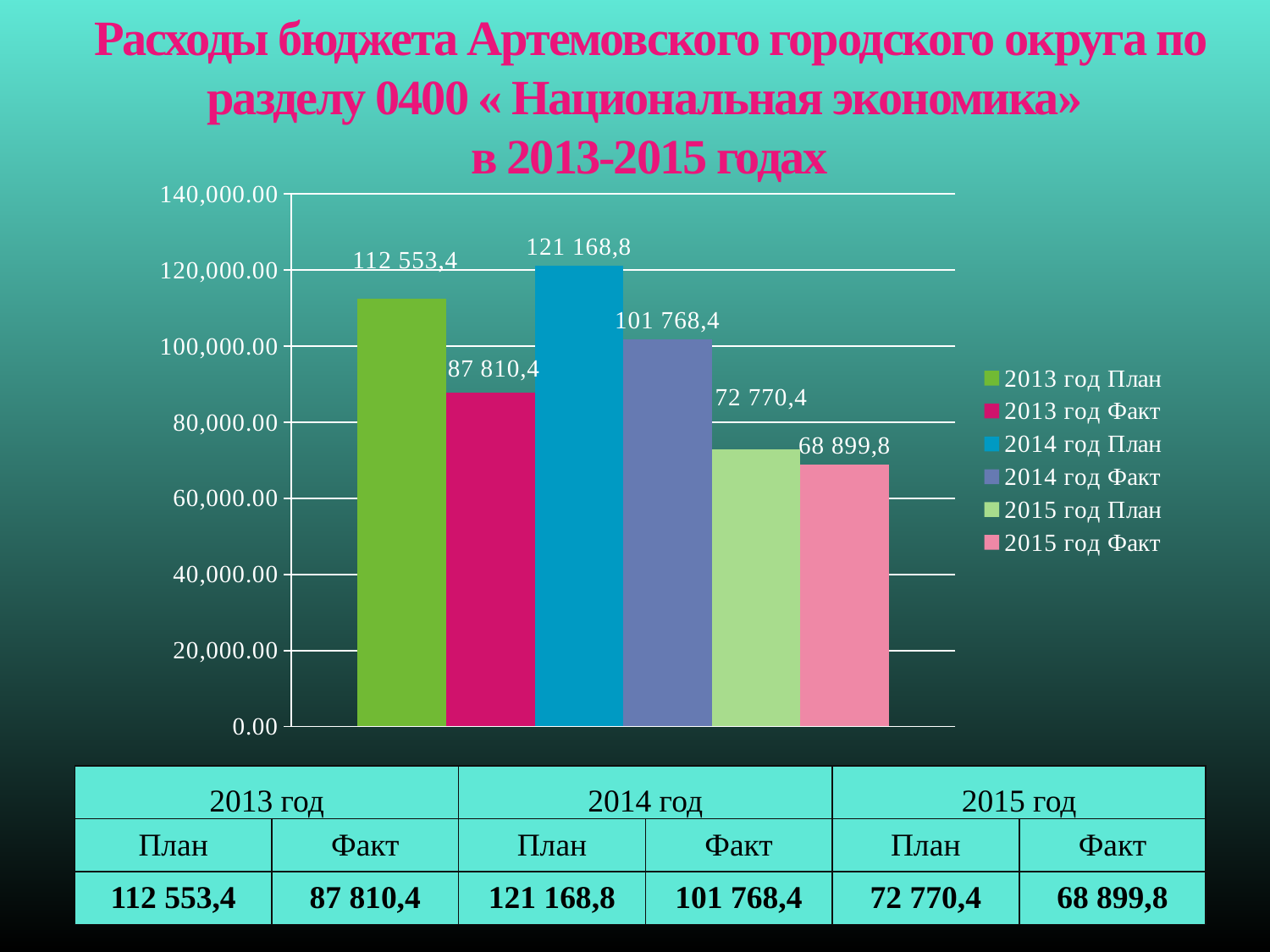
What is the difference between 2013 год План and 2013 год Факт? 24 743,0 Is the value for 2013 год Факт greater or less than 80,000.00? greater Which series has the lowest value? 2015 год Факт What type of chart is shown on the slide? bar chart What is the value for 2014 год Факт? 101 768,4 What is the value for 2015 год Факт? 68 899,8 What is the value for 2013 год План? 112 553,4 How many series does the legend list? 6 Which series has the highest value? 2014 год План What is the difference between 2014 год План and 2014 год Факт? 19 400,4 Which is larger, 2013 год Факт or 2014 год Факт? 2014 год Факт How many bars are plotted in the chart? 6